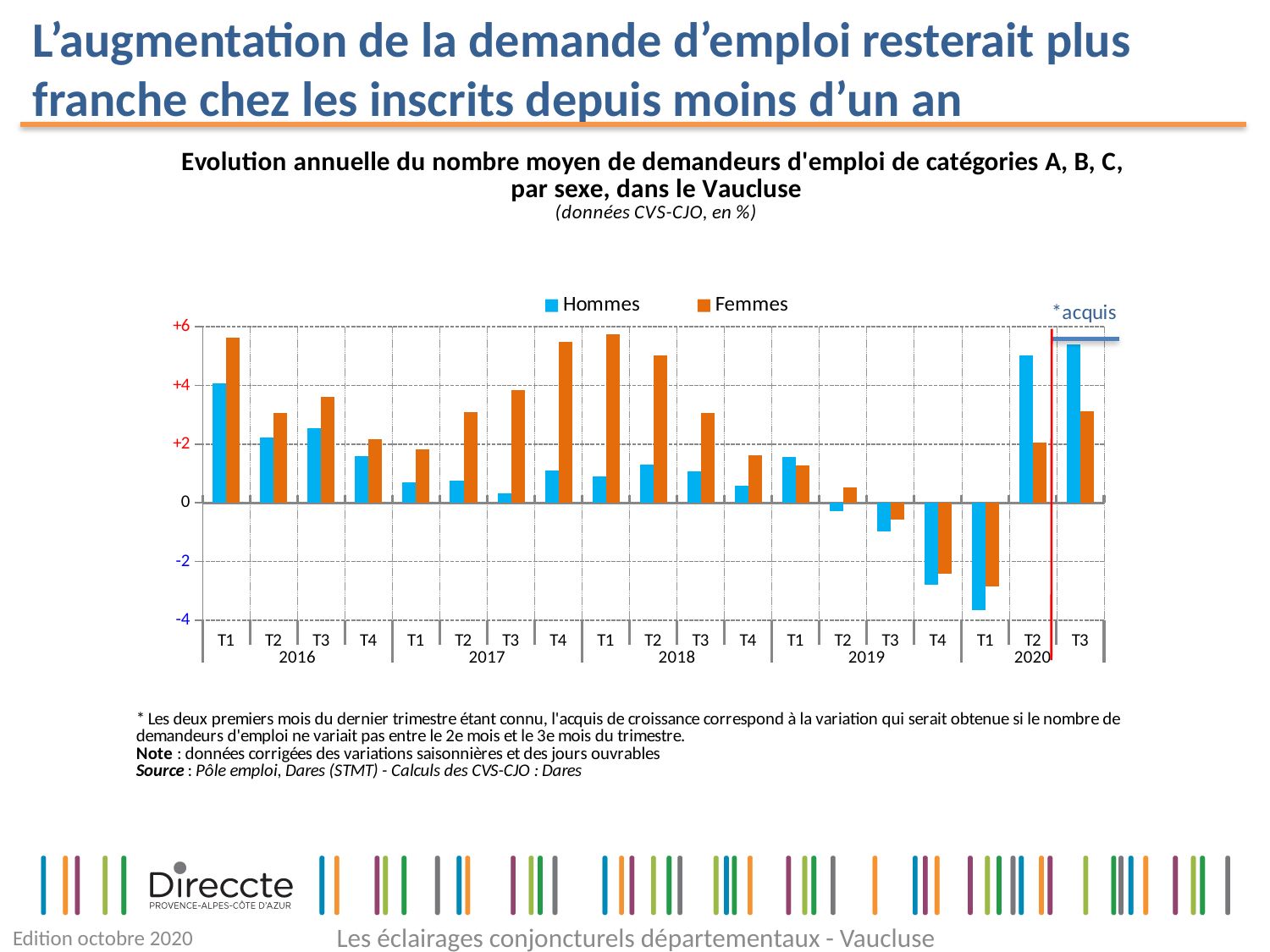
Is the value for Femmes in T3 2019 greater or less than 0? less Is the value for Hommes in T1 2020 greater or less than -2? less How many quarters are plotted along the x axis? 19 Is the value for Hommes in T3 2017 greater or less than +2? less In which quarter is the Hommes value lowest? T1 2020 Which colour represents the Femmes series? orange How many series does the legend list? 2 In T2 2020, which series has the larger value, Hommes or Femmes? Hommes Across the four quarters of 2019, do the Hommes values rise or fall? fall What are the two series named in the legend? Hommes and Femmes What kind of chart is shown on the slide? bar chart